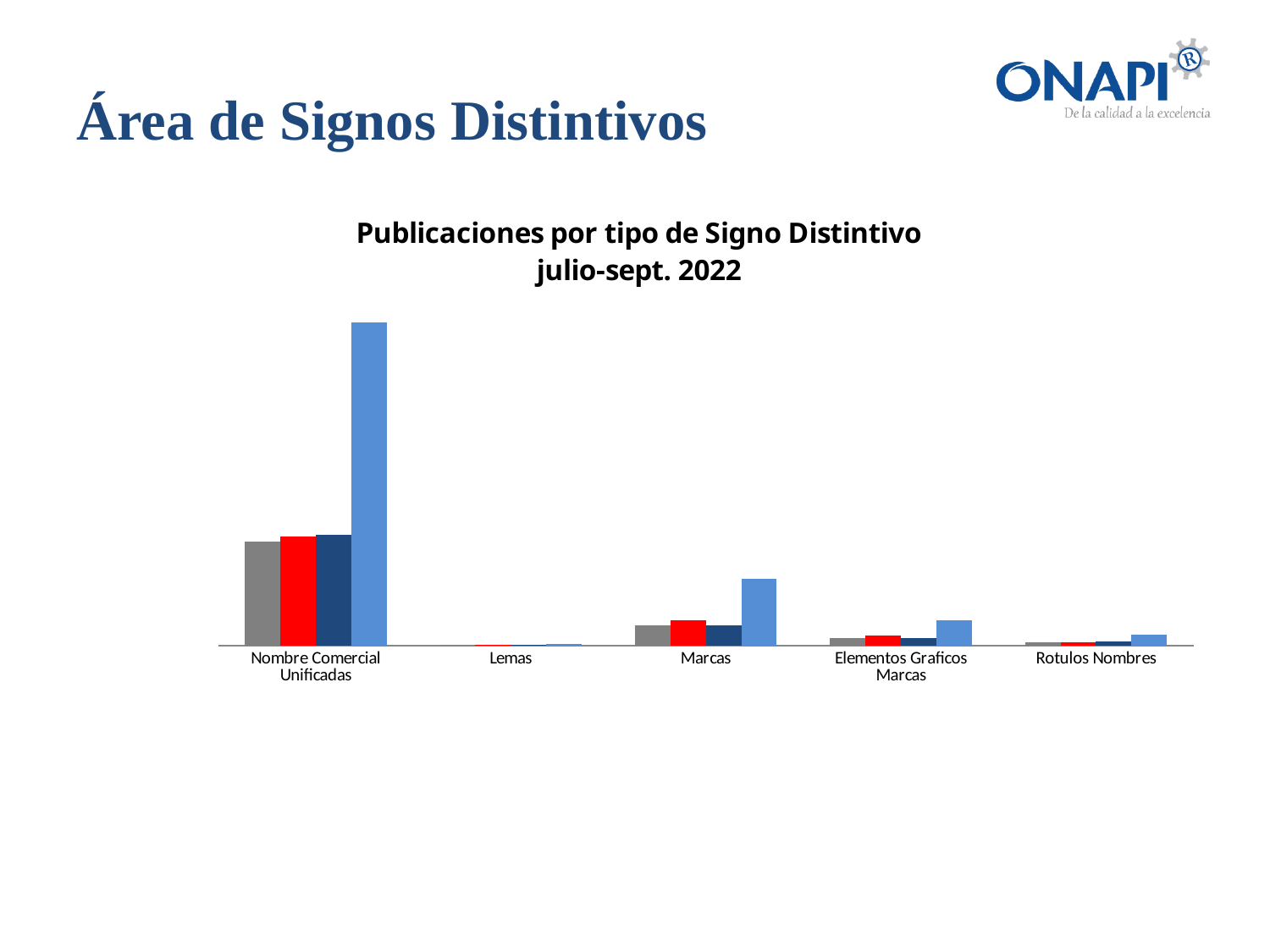
Which category has the highest values in the chart? Nombre Comercial Unificadas What is the title of the chart? Publicaciones por tipo de Signo Distintivo julio-sept. 2022 How many bars are plotted for each category in the chart? 4 Within the Nombre Comercial Unificadas category, which coloured bar is the tallest? light blue Which category has the lowest values in the chart? Lemas What kind of chart is shown on the slide? bar chart Which category has the larger light blue bar, Rotulos Nombres or Lemas? Rotulos Nombres How many categories are shown on the x axis of the chart? 5 Which category has the larger red bar, Marcas or Rotulos Nombres? Marcas Which category has the second-highest values in the chart? Marcas